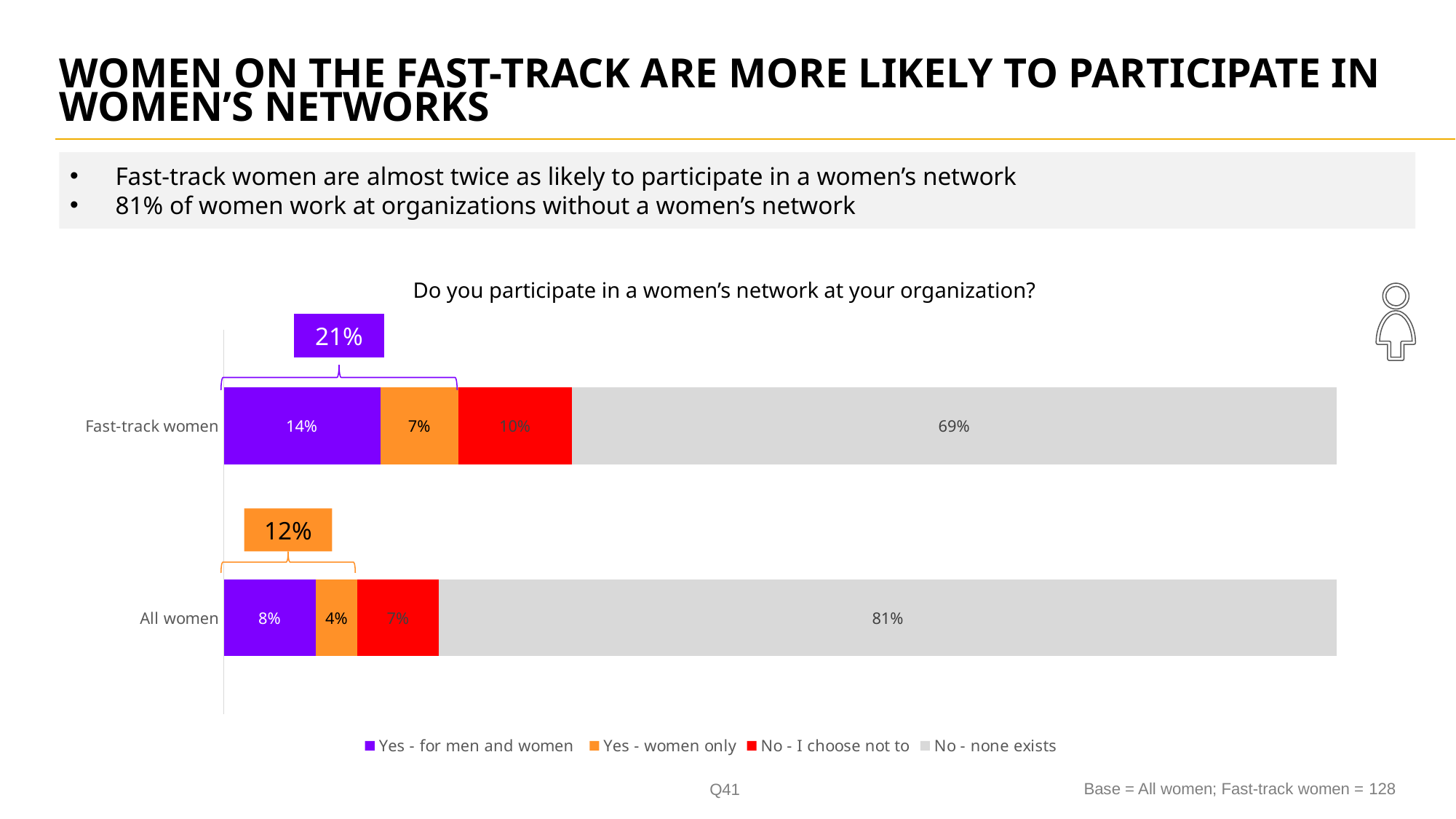
What kind of chart is shown on the slide? Stacked bar chart What is the combined "Yes" share (both Yes responses) for All women, as labelled above the bar? 12% How many series does the legend list? 4 What percentage of Fast-track women answered "Yes - women only"? 7% What percentage of All women answered "No - I choose not to"? 7% What is the combined "Yes" share (both Yes responses) for Fast-track women, as labelled above the bar? 21% How many categories (bars) are shown in the chart? 2 What is the title of the chart? Do you participate in a women's network at your organization? What is the difference between the "Yes - for men and women" values for Fast-track women and All women? 6% Which category has the higher value for "No - none exists", Fast-track women or All women? All women What percentage of Fast-track women answered "No - none exists"? 69% What percentage of All women answered "Yes - for men and women"? 8%